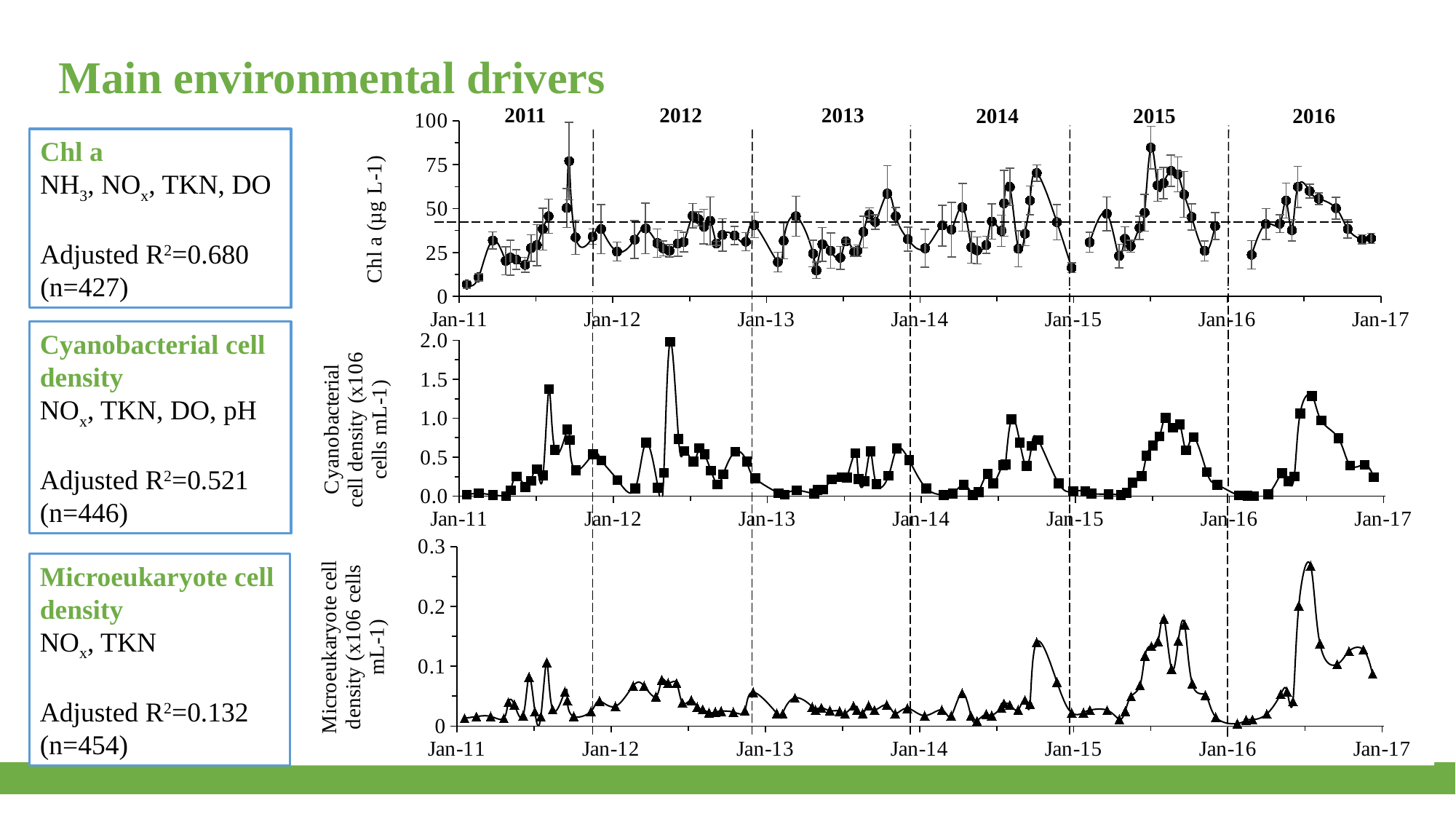
In the Microeukaryote cell density chart, is the highest peak in 2016 greater or less than 0.2? greater What is the maximum value shown on the y-axis of the Microeukaryote cell density chart? 0.3 In the Microeukaryote cell density chart, in which year does the highest value occur? 2016 In the Chl a chart, is the highest value in 2015 greater or less than 75? greater What is the y-axis label of the top chart? Chl a (µg L-1) In the Microeukaryote cell density chart, is the 2015 peak higher or lower than the 2016 peak? lower How many charts are shown on the slide? 3 In the Cyanobacterial cell density chart, is the highest peak in 2012 greater or less than 1.5? greater In the Cyanobacterial cell density chart, in which year does the highest value occur? 2012 What kind of chart is the top chart showing Chl a? line chart